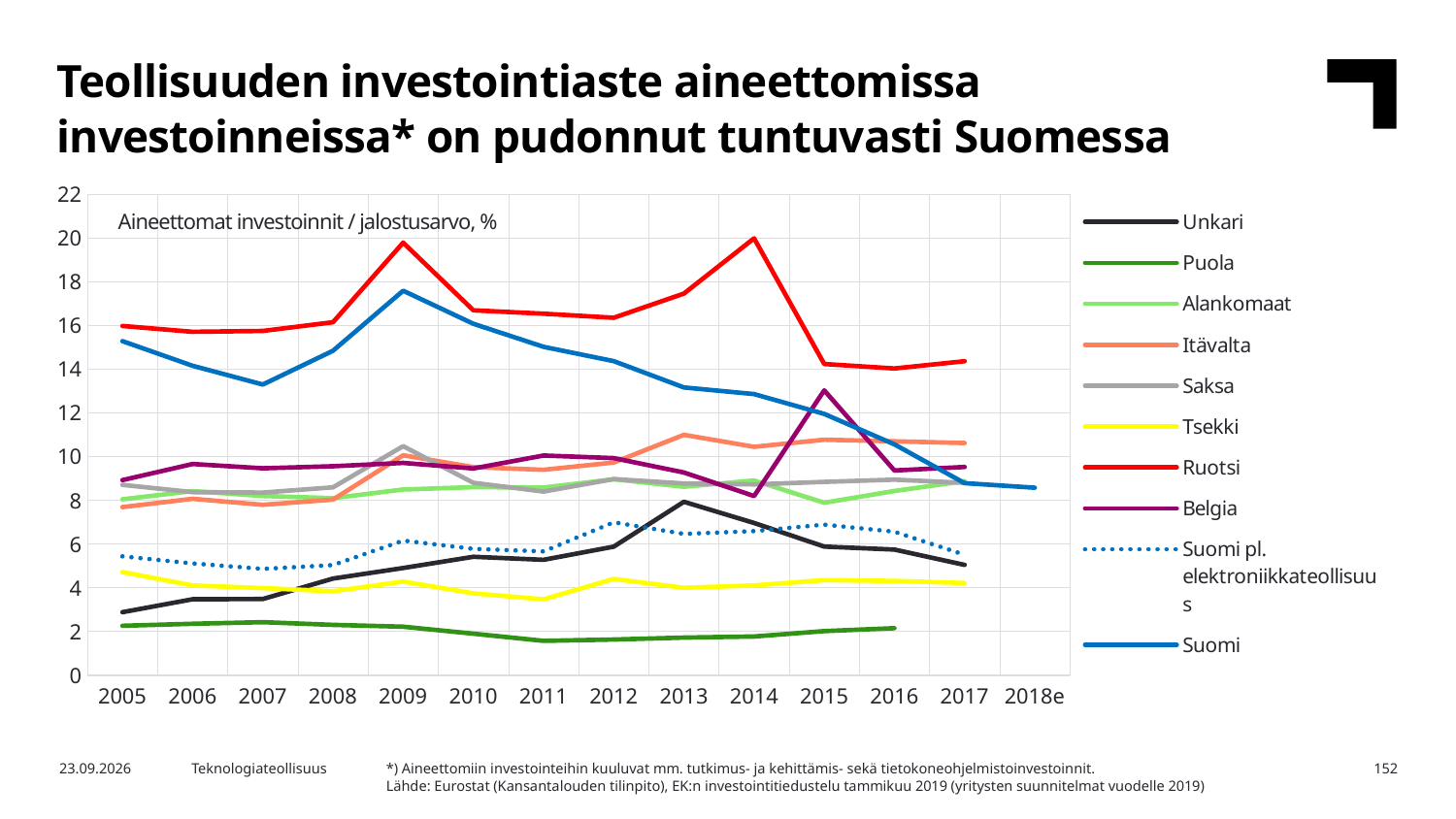
Which series has the highest value in 2014? Ruotsi Is the value for Ruotsi in 2009 greater or less than 18? greater Does the value for Suomi rise or fall from 2009 to 2018e? fall Is the value for Puola in 2011 greater or less than 2? less How many series does the legend list? 10 Which series is drawn with a dotted line? Suomi pl. elektroniikkateollisuus Is the value for Belgia in 2015 greater or less than 12? greater In 2014, which is larger, the value for Ruotsi or the value for Suomi? Ruotsi What kind of chart is shown on the slide? line chart How many years are shown on the x axis? 14 Which series has the lowest value in 2005? Puola